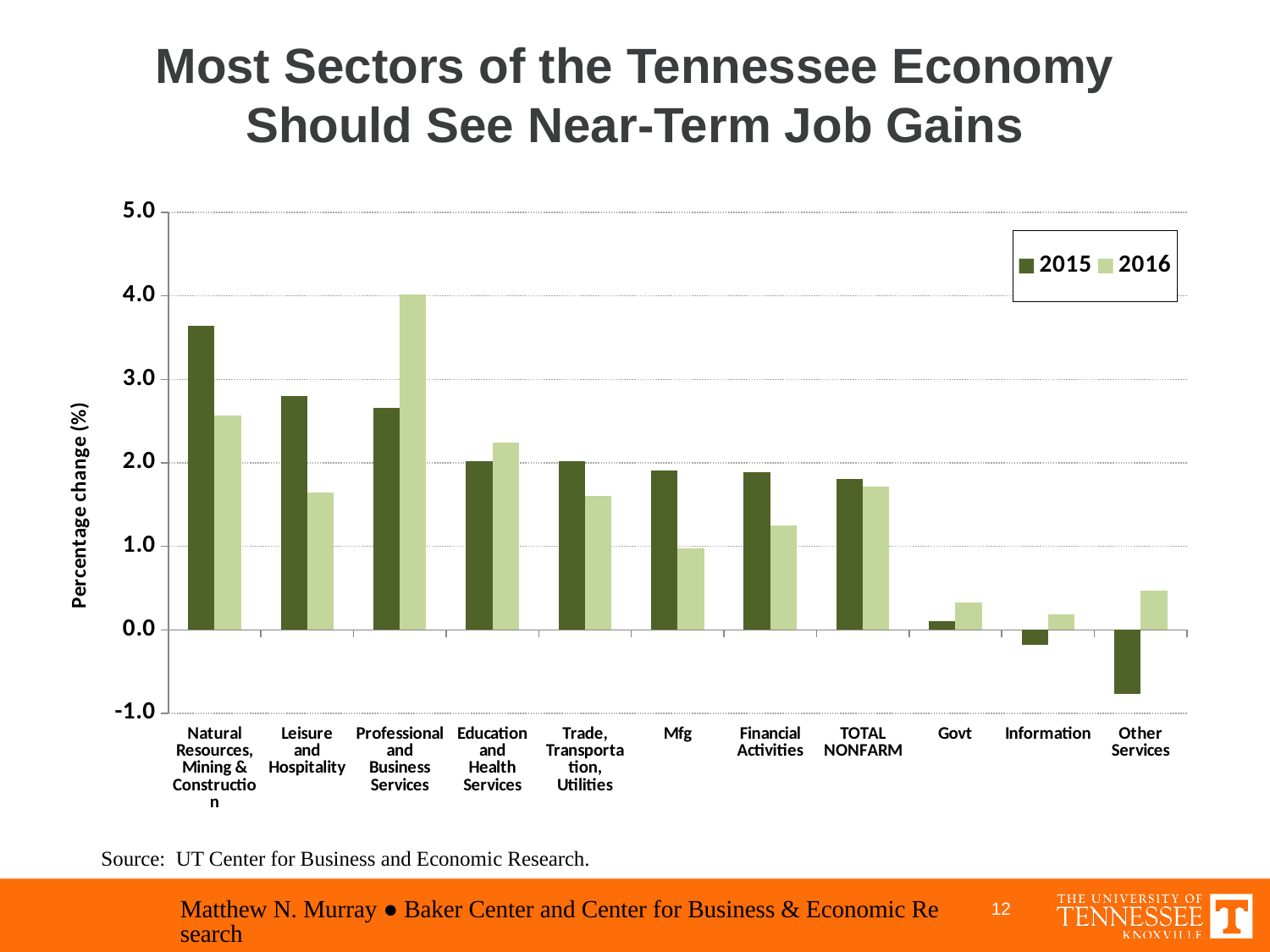
Is the 2015 value for Other Services greater or less than 0.0? less Which sector has the highest 2016 value? Professional and Business Services Which sector has the lowest 2015 value? Other Services Do the 2015 values generally rise or fall moving from left to right across the sectors? fall Is the 2016 value for Professional and Business Services greater or less than 3.0? greater How many sectors (categories) are shown along the x axis? 11 For Leisure and Hospitality, which year has the larger value, 2015 or 2016? 2015 What kind of chart is shown on the slide? bar chart Is the 2015 value for Natural Resources, Mining & Construction greater or less than 3.0? greater Which sector has the highest 2015 value? Natural Resources, Mining & Construction How many series does the legend list? 2 For Professional and Business Services, which year has the larger value, 2015 or 2016? 2016